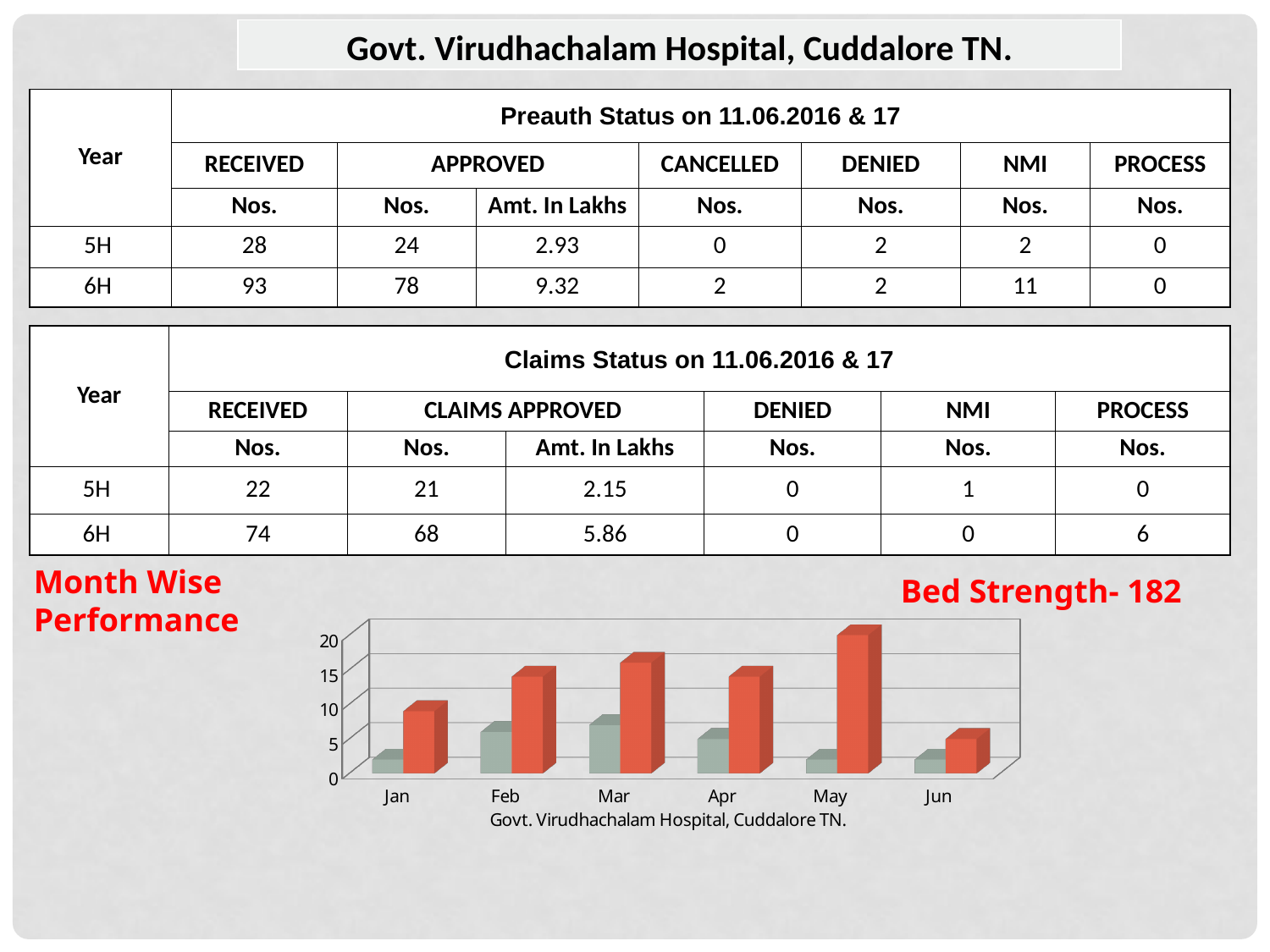
What text appears directly below the x axis of the bar chart? Govt. Virudhachalam Hospital, Cuddalore TN. Is the red bar for May greater or less than 15? greater How many months are shown on the x axis of the bar chart? 6 In the bar chart, which month has the shortest red bar? Jun How many bars are plotted for each month in the bar chart? 2 Is the red bar for Mar greater or less than 10? greater What kind of chart is shown under the heading 'Month Wise Performance'? bar chart In the bar chart, which month has the tallest red bar? May Is the grey bar for Jan greater or less than 5? less Which is larger in the bar chart: the red bar for Mar or the red bar for Jan? Mar Do the red bars rise or fall from May to Jun? fall